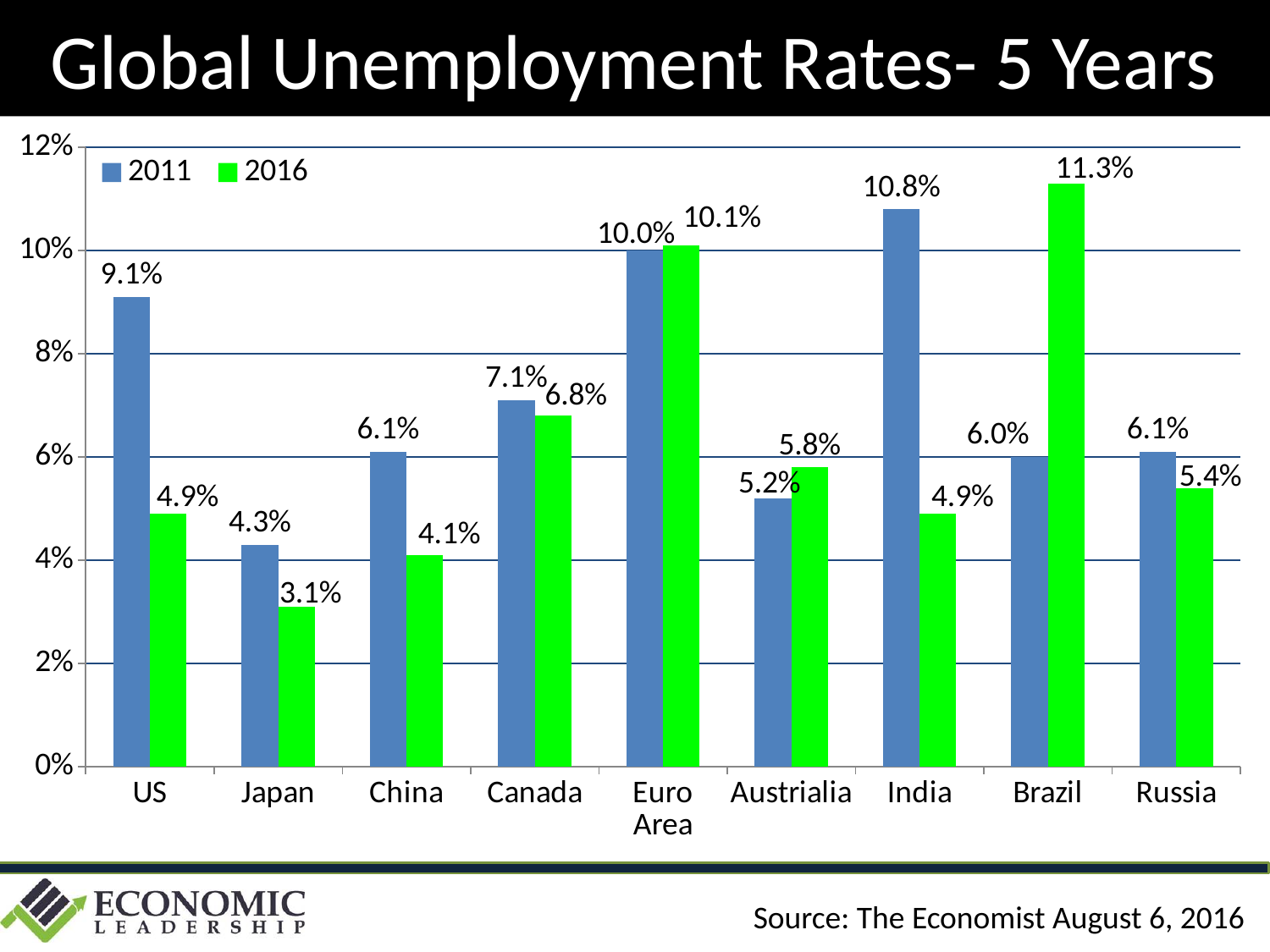
What colour represents the 2016 series in the chart? Green What was the unemployment rate for the US in 2011? 9.1% What kind of chart is shown on the slide? Bar chart By how many percentage points did the US unemployment rate fall from 2011 to 2016? 4.2 percentage points Which country or region had the highest unemployment rate in 2016? Brazil What was the unemployment rate for Japan in 2016? 3.1% What was the unemployment rate for Brazil in 2016? 11.3% What is the difference between Brazil's 2016 and 2011 unemployment rates? 5.3 percentage points How many series does the legend list? 2 How many countries or regions are shown on the x axis? 9 Which country or region had the lowest unemployment rate in 2011? Japan Which was higher for India: the 2011 rate or the 2016 rate? 2011